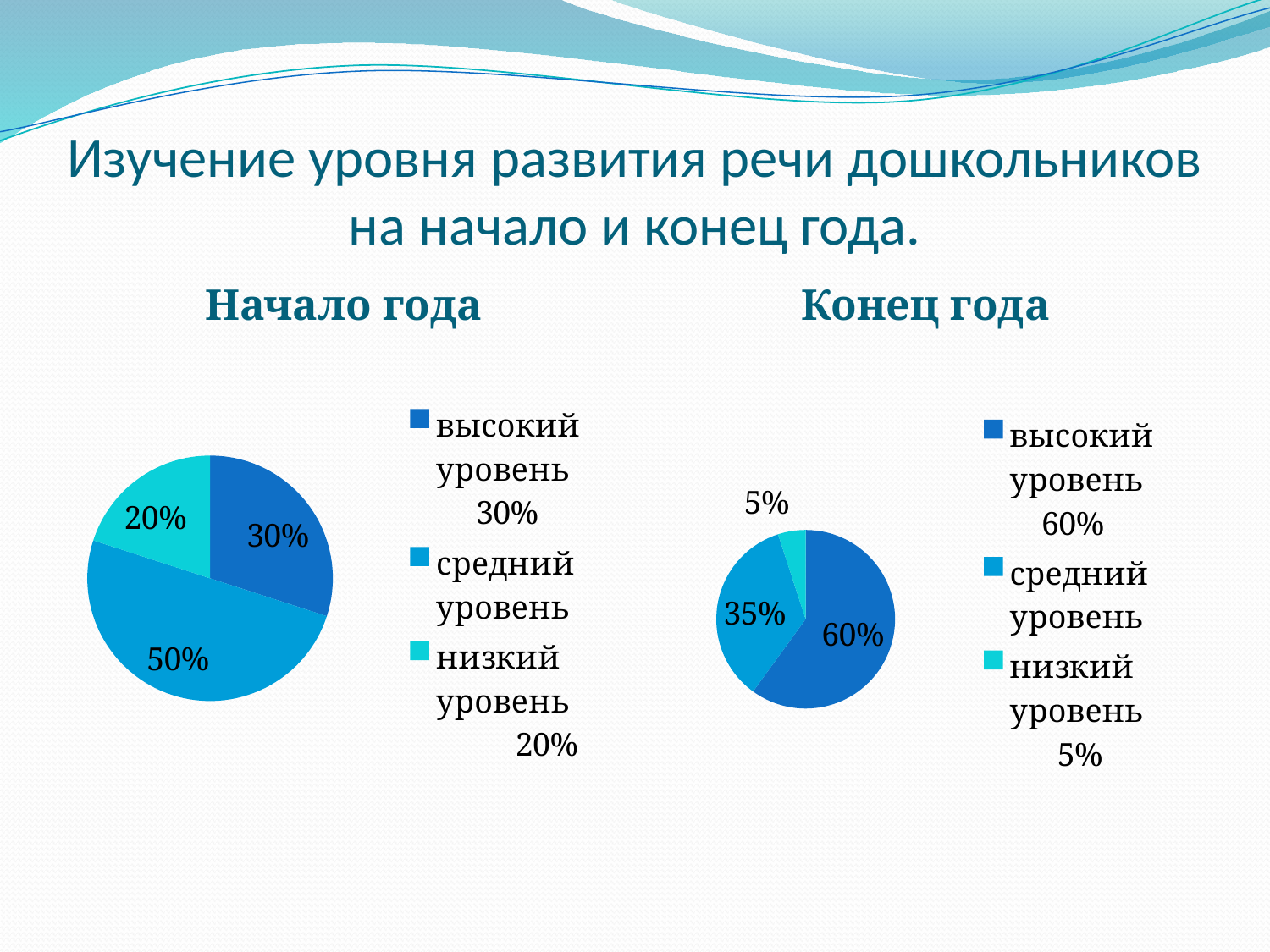
In the "Начало года" chart, what share does "высокий уровень" have? 30% In the "Начало года" chart, what share does "средний уровень" have? 50% How many entries does the legend of the "Начало года" chart list? 3 In the "Начало года" chart, which category has the largest slice? средний уровень What is the difference between the "высокий уровень" share in the "Конец года" chart and in the "Начало года" chart? 30% In the "Конец года" chart, which category has the smallest slice? низкий уровень In the "Конец года" chart, what share does "низкий уровень" have? 5% In the "Начало года" chart, which is larger: "высокий уровень" or "низкий уровень"? высокий уровень In the "Конец года" chart, what share does "высокий уровень" have? 60% How many slices does the "Конец года" chart have? 3 What type of chart is used for "Начало года"? Pie chart In the "Конец года" chart, which category has the largest slice? высокий уровень